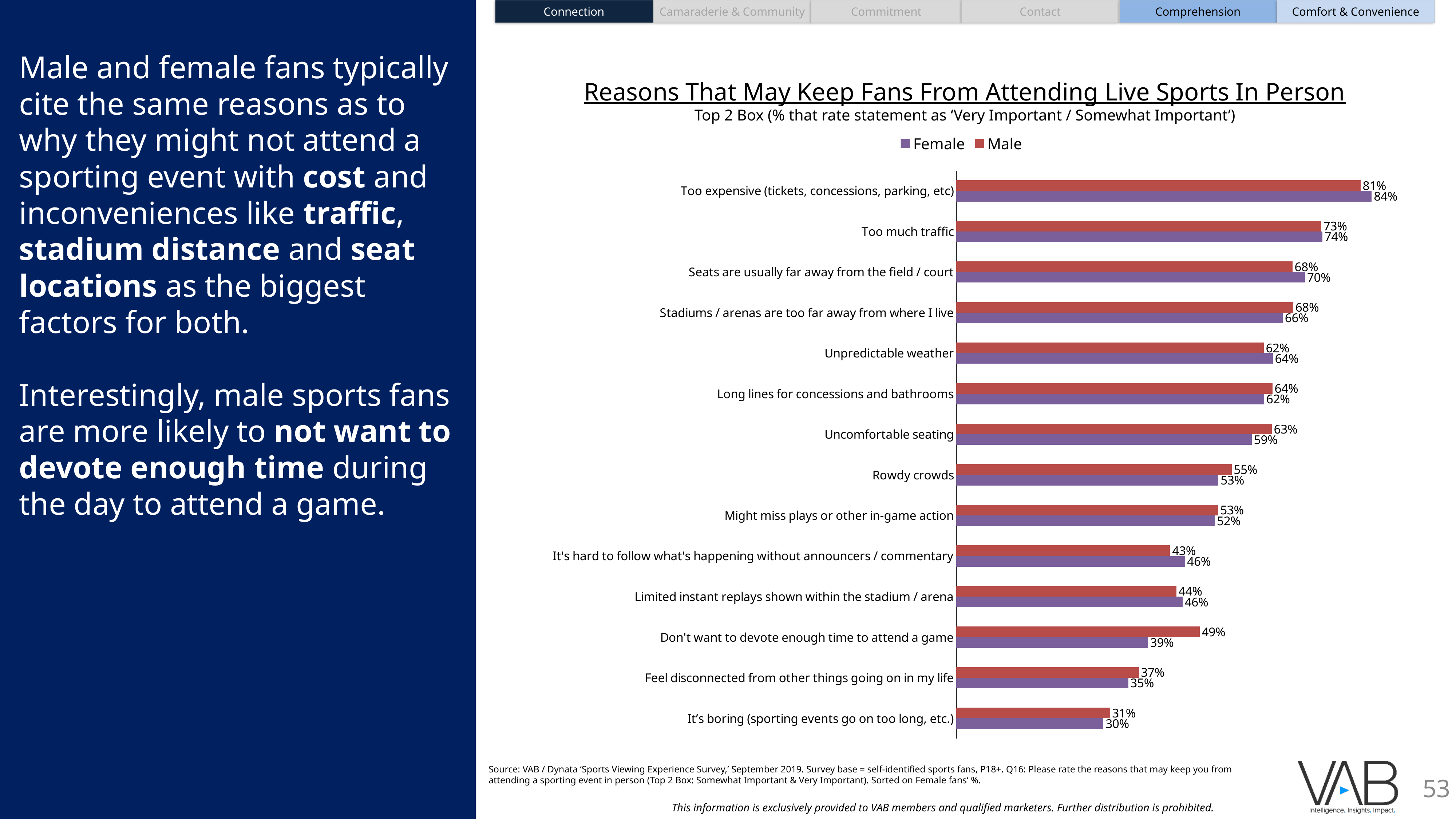
What is the Male value for 'Unpredictable weather'? 62% What is the difference between the Female and Male values for 'Too expensive (tickets, concessions, parking, etc)'? 3 percentage points What is the difference between the Male and Female values for 'Don't want to devote enough time to attend a game'? 10 percentage points How many series does the legend list? 2 Which colour represents Male fans in the chart? Red What percentage of female fans rate 'Too expensive (tickets, concessions, parking, etc)' as important? 84% What percentage of male fans rate 'Don't want to devote enough time to attend a game' as important? 49% For 'Uncomfortable seating', is the Male or Female value larger? Male Which reason has the lowest Male value? It's boring (sporting events go on too long, etc.) What type of chart is shown on the slide? Bar chart Which reason has the highest Female value? Too expensive (tickets, concessions, parking, etc) How many reasons are listed in the chart? 14